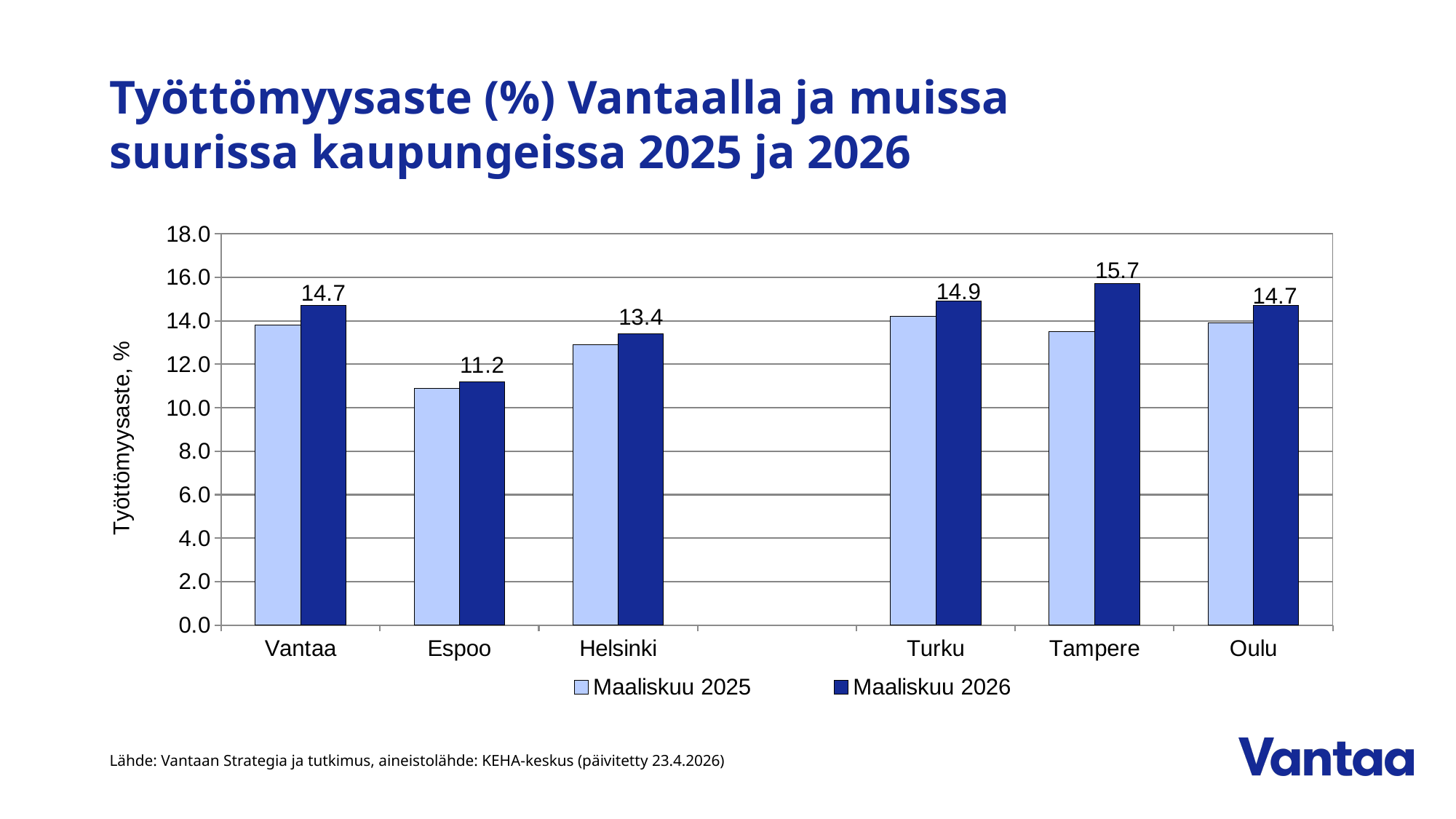
What kind of chart is shown on the slide? bar chart What is the unemployment rate for Espoo in Maaliskuu 2026? 11.2 How many series does the legend list? 2 How many cities are shown on the x axis of the chart? 6 What is the unemployment rate for Tampere in Maaliskuu 2026? 15.7 Which city has the lowest unemployment rate in Maaliskuu 2026? Espoo What is the unemployment rate for Helsinki in Maaliskuu 2026? 13.4 What is the difference between the Maaliskuu 2026 unemployment rates of Tampere and Espoo? 4.5 Which city has the higher unemployment rate in Maaliskuu 2026, Turku or Helsinki? Turku Is the value for Tampere in Maaliskuu 2025 greater or less than 14.0? less Which city has the highest unemployment rate in Maaliskuu 2026? Tampere Is the value for Espoo in Maaliskuu 2025 greater or less than 12.0? less